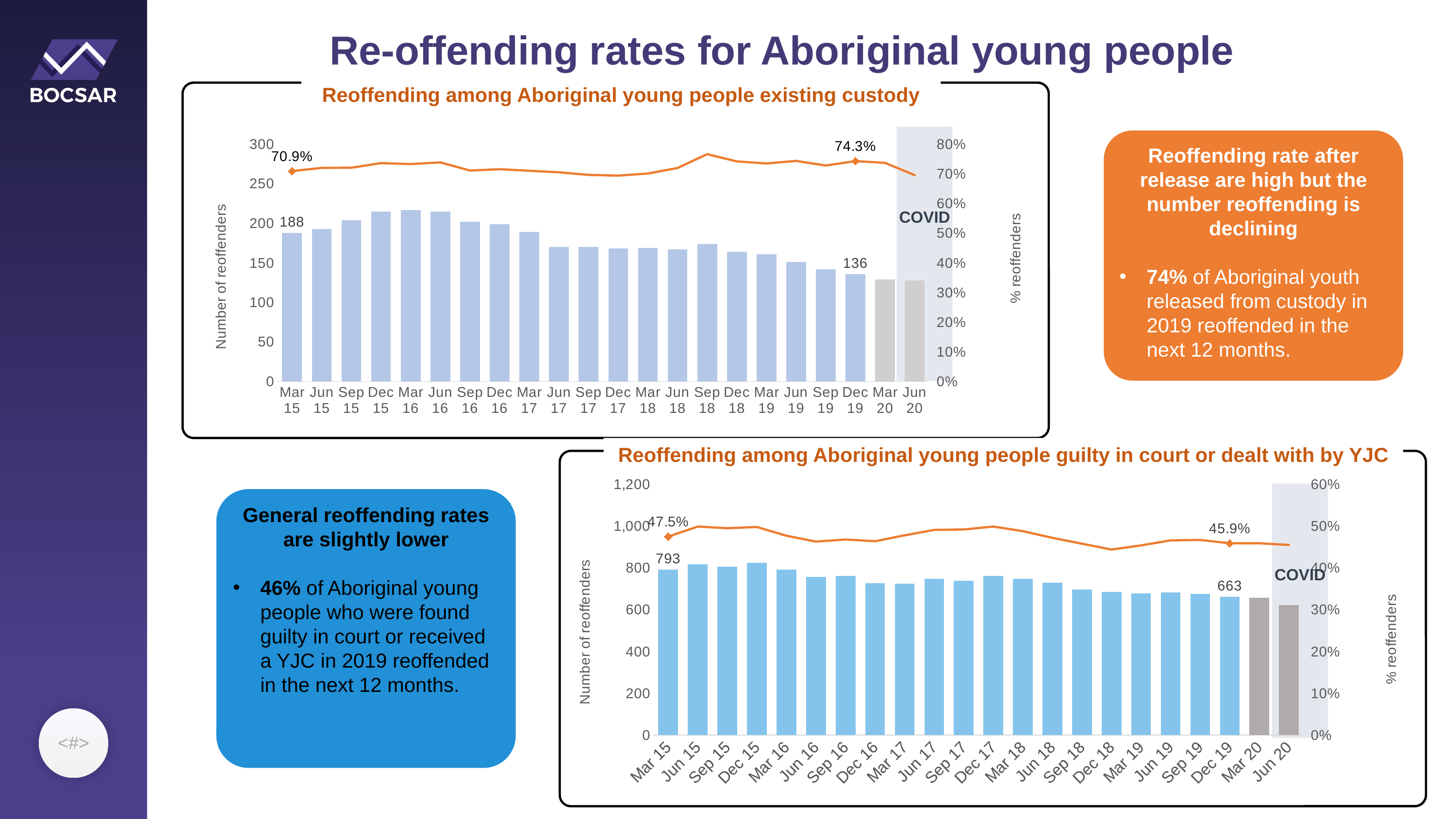
In the top chart (Reoffending among Aboriginal young people existing custody), what is the % reoffenders value for Dec 19? 74.3% How many quarters are shown on the x axis of the bottom chart (Reoffending among Aboriginal young people guilty in court or dealt with by YJC)? 22 In the top chart (Reoffending among Aboriginal young people existing custody), is the number of reoffenders for Mar 16 greater or less than 200? greater In the top chart (Reoffending among Aboriginal young people existing custody), is the % reoffenders value higher in Mar 15 or Dec 19? Dec 19 In the bottom chart (Reoffending among Aboriginal young people guilty in court or dealt with by YJC), what is the number of reoffenders for Dec 19? 663 In the top chart (Reoffending among Aboriginal young people existing custody), what is the % reoffenders value for Mar 15? 70.9% In the top chart (Reoffending among Aboriginal young people existing custody), what is the number of reoffenders for Dec 19? 136 In the bottom chart (Reoffending among Aboriginal young people guilty in court or dealt with by YJC), what is the number of reoffenders for Mar 15? 793 In the top chart (Reoffending among Aboriginal young people existing custody), what is the number of reoffenders for Mar 15? 188 In the bottom chart (Reoffending among Aboriginal young people guilty in court or dealt with by YJC), what is the difference between the number of reoffenders in Mar 15 and Dec 19? 130 In the bottom chart (Reoffending among Aboriginal young people guilty in court or dealt with by YJC), what is the % reoffenders value for Dec 19? 45.9% In the top chart (Reoffending among Aboriginal young people existing custody), by how much did the number of reoffenders fall from Mar 15 to Dec 19? 52